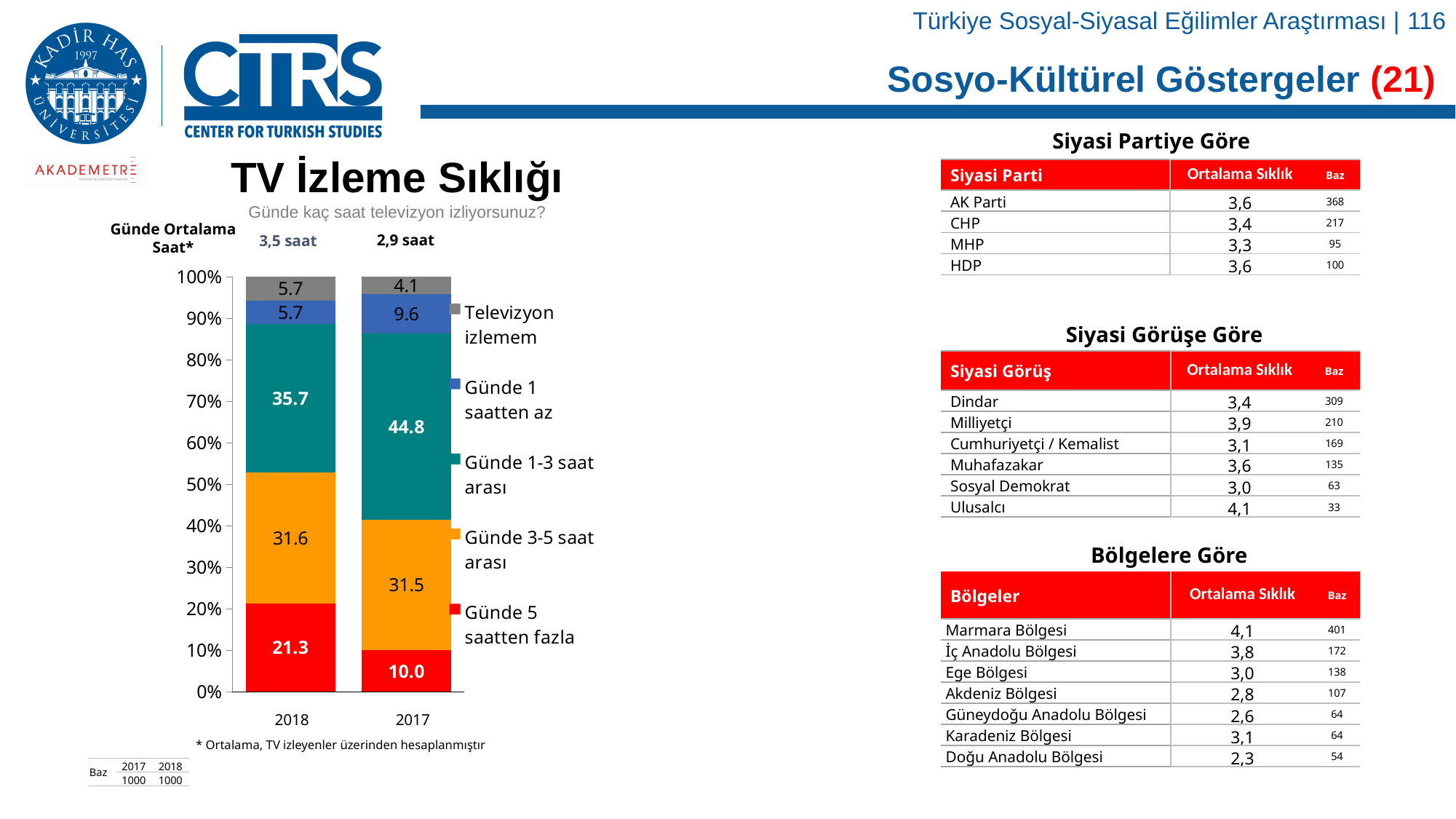
In the TV İzleme Sıklığı chart, what is the value for "Günde 1-3 saat arası" in 2017? 44.8 In the TV İzleme Sıklığı chart, what colour represents "Günde 3-5 saat arası"? orange In the TV İzleme Sıklığı chart, which category has the smallest share in the 2017 bar? Televizyon izlemem In the TV İzleme Sıklığı chart, what is the value for "Günde 5 saatten fazla" in 2018? 21.3 How many series does the legend of the TV İzleme Sıklığı chart list? 5 In the TV İzleme Sıklığı chart, what is the difference between the "Günde 5 saatten fazla" values for 2018 and 2017? 11.3 What kind of chart is shown under the title "TV İzleme Sıklığı"? stacked bar chart In the TV İzleme Sıklığı chart, what is the value for "Günde 1 saatten az" in 2017? 9.6 In the TV İzleme Sıklığı chart, what is the value for "Televizyon izlemem" in 2018? 5.7 In the TV İzleme Sıklığı chart, which category has the largest share in the 2017 bar? Günde 1-3 saat arası In the TV İzleme Sıklığı chart, is the "Günde 1-3 saat arası" value larger in 2018 or 2017? 2017 How many bars (years) are shown in the TV İzleme Sıklığı chart? 2